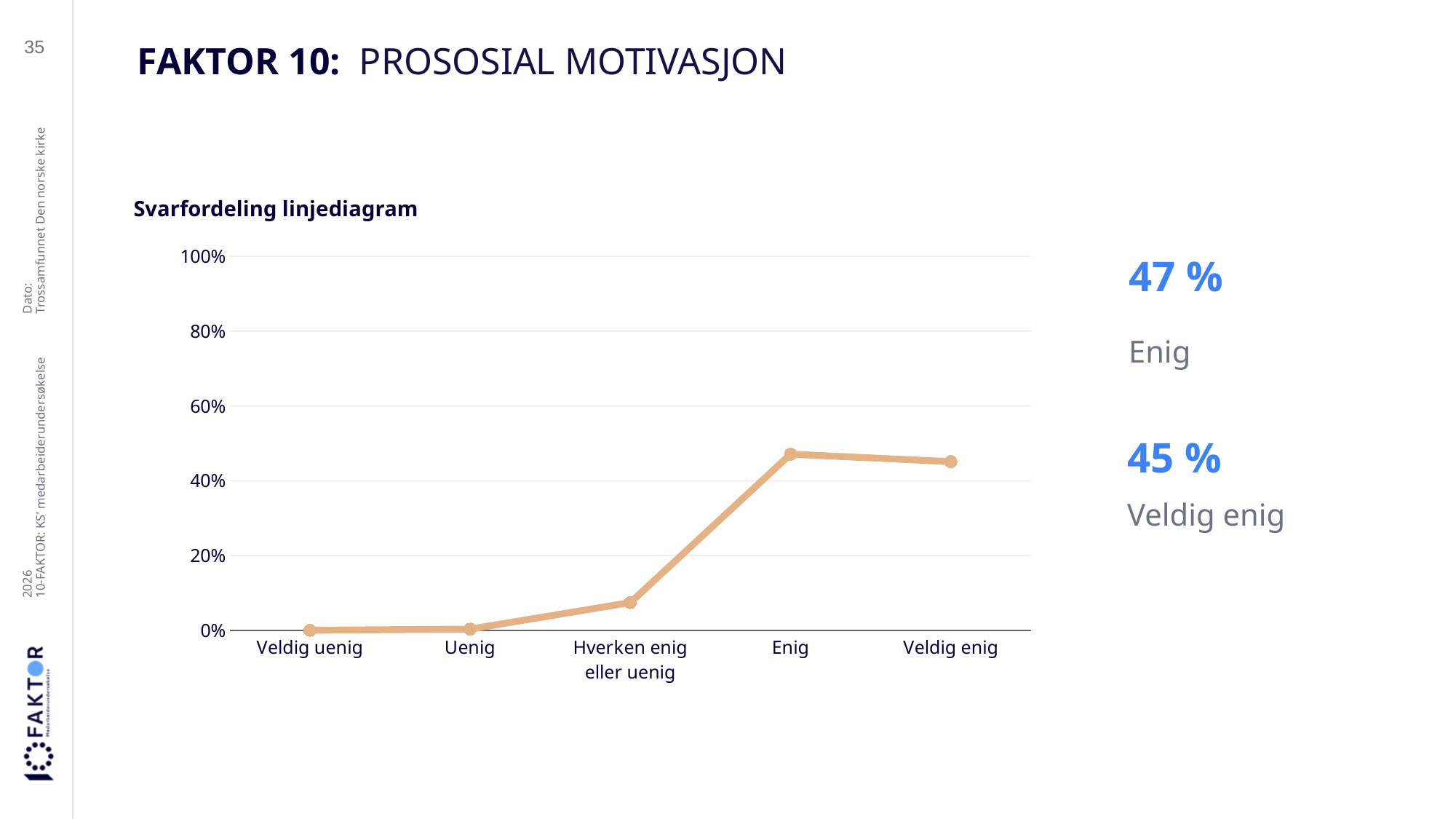
What is the value for Enig? 47 % Is the value for Hverken enig eller uenig greater or less than 20%? less What is the value for Veldig enig? 45 % Which is larger, the value for Enig or the value for Veldig enig? Enig What kind of chart is shown under "Svarfordeling linjediagram"? line chart What is the title of the chart? Svarfordeling linjediagram Is the value for Enig greater or less than 40%? greater Which category has the highest value? Enig Is the value for Veldig enig greater or less than 60%? less What is the difference between the values for Enig and Veldig enig? 2 % How many categories are shown on the x axis of the chart? 5 Do the values generally rise or fall from Veldig uenig to Enig along the x axis? rise